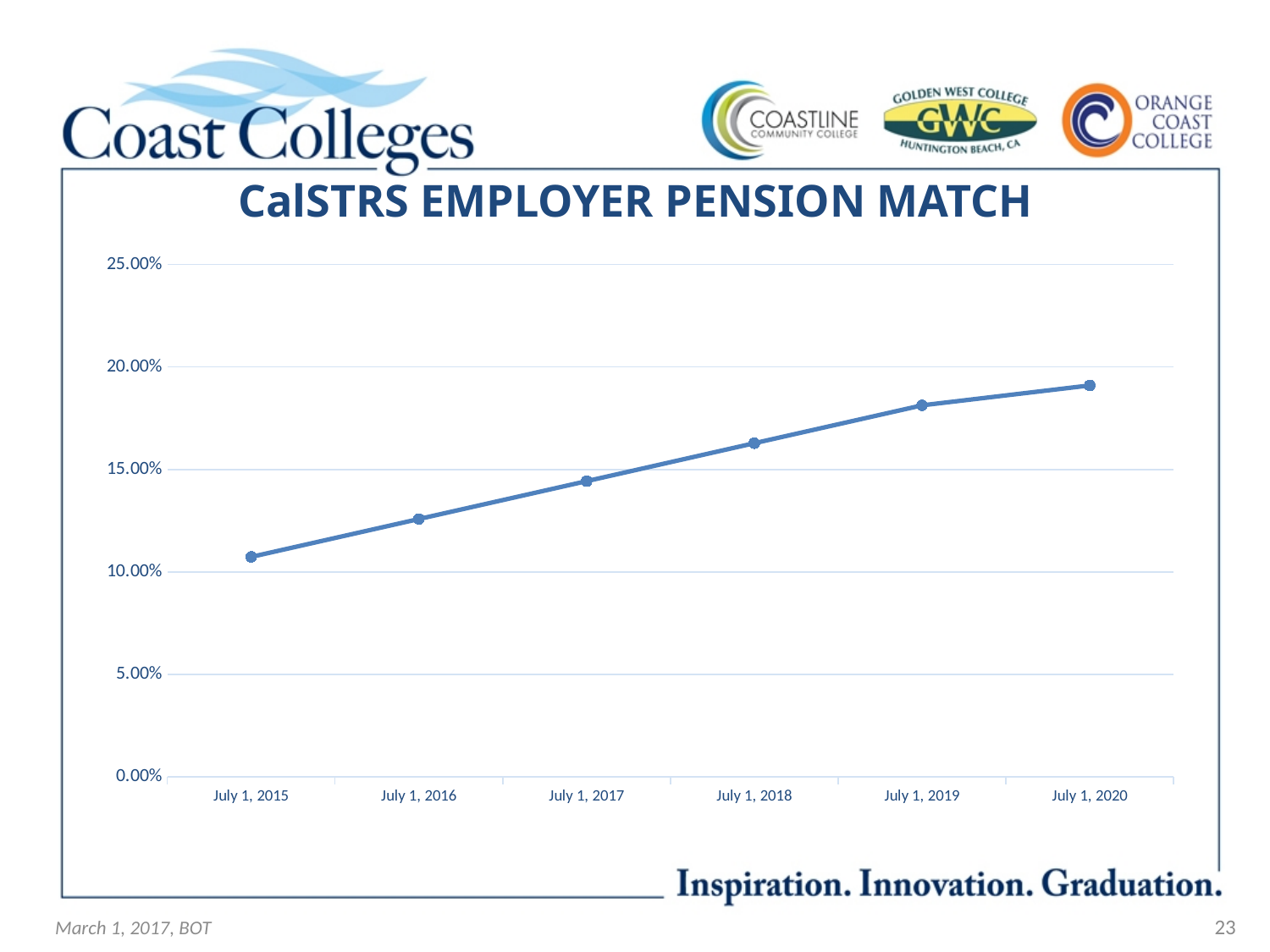
Which is larger, the value for July 1, 2019 or the value for July 1, 2016? July 1, 2019 Do the values rise or fall from July 1, 2015 to July 1, 2020? rise How many data points are plotted on the line? 6 Is the value for July 1, 2016 greater or less than 10.00%? greater Which date has the lowest employer pension match? July 1, 2015 Which date has the highest employer pension match? July 1, 2020 What is the highest value shown on the vertical axis? 25.00% What kind of chart is shown on the slide? line chart Is the value for July 1, 2020 greater or less than 20.00%? less Is the value for July 1, 2018 greater or less than 15.00%? greater What is the title of the chart? CalSTRS EMPLOYER PENSION MATCH